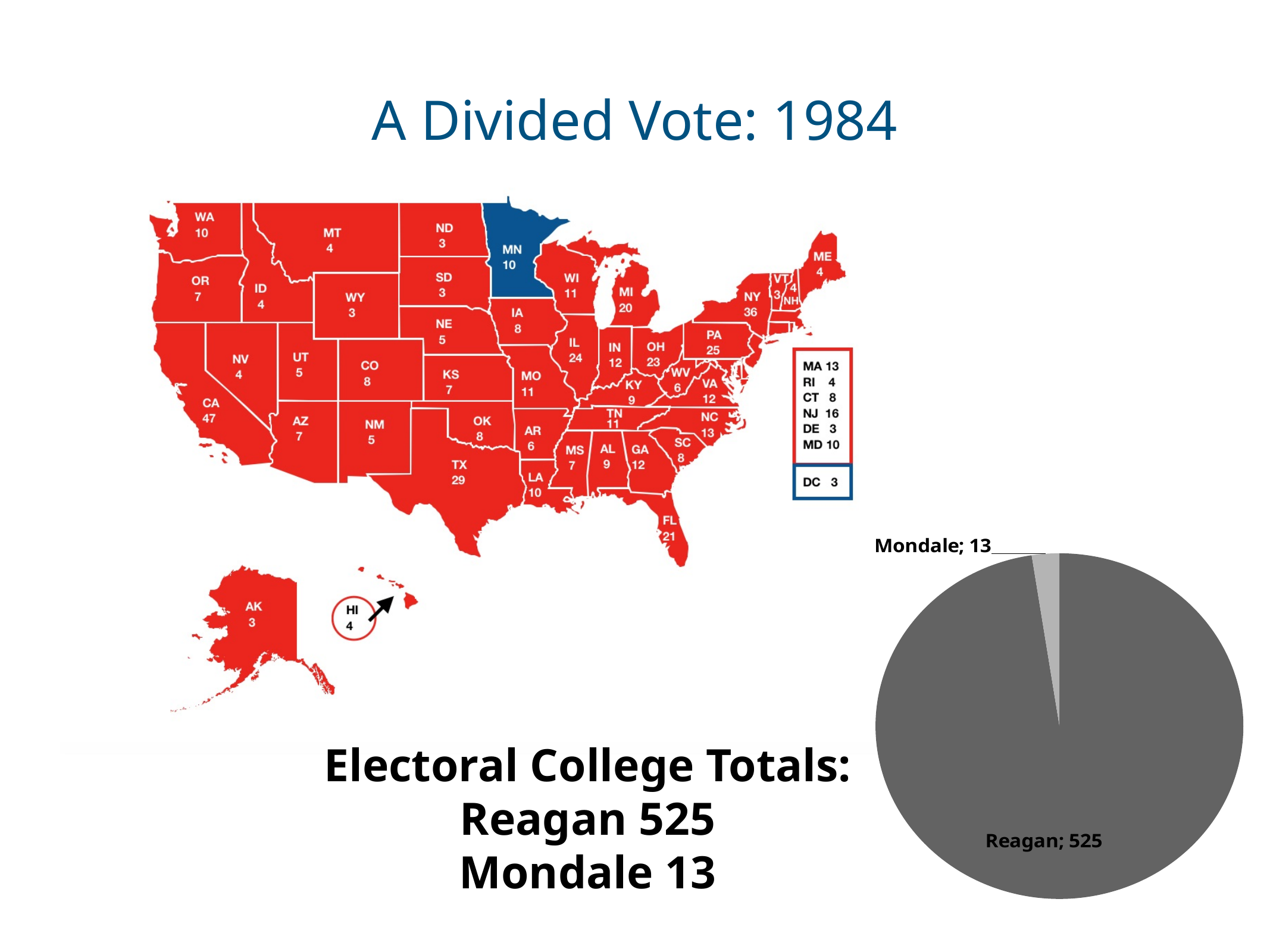
In the pie chart, what is the value for Reagan? 525 How many slices does the pie chart have? 2 What is the difference between Reagan's and Mondale's values in the pie chart? 512 What is the total of the two values shown in the pie chart? 538 Which is larger in the pie chart, Reagan's value or Mondale's value? Reagan According to the text on the slide, what are the Electoral College totals for Reagan and Mondale? Reagan 525, Mondale 13 Which candidate's slice in the pie chart is shown in the lighter grey colour? Mondale Which slice of the pie chart is the largest? Reagan In the pie chart, what is the value for Mondale? 13 What kind of chart is shown on the slide? pie chart Which slice of the pie chart is the smallest? Mondale